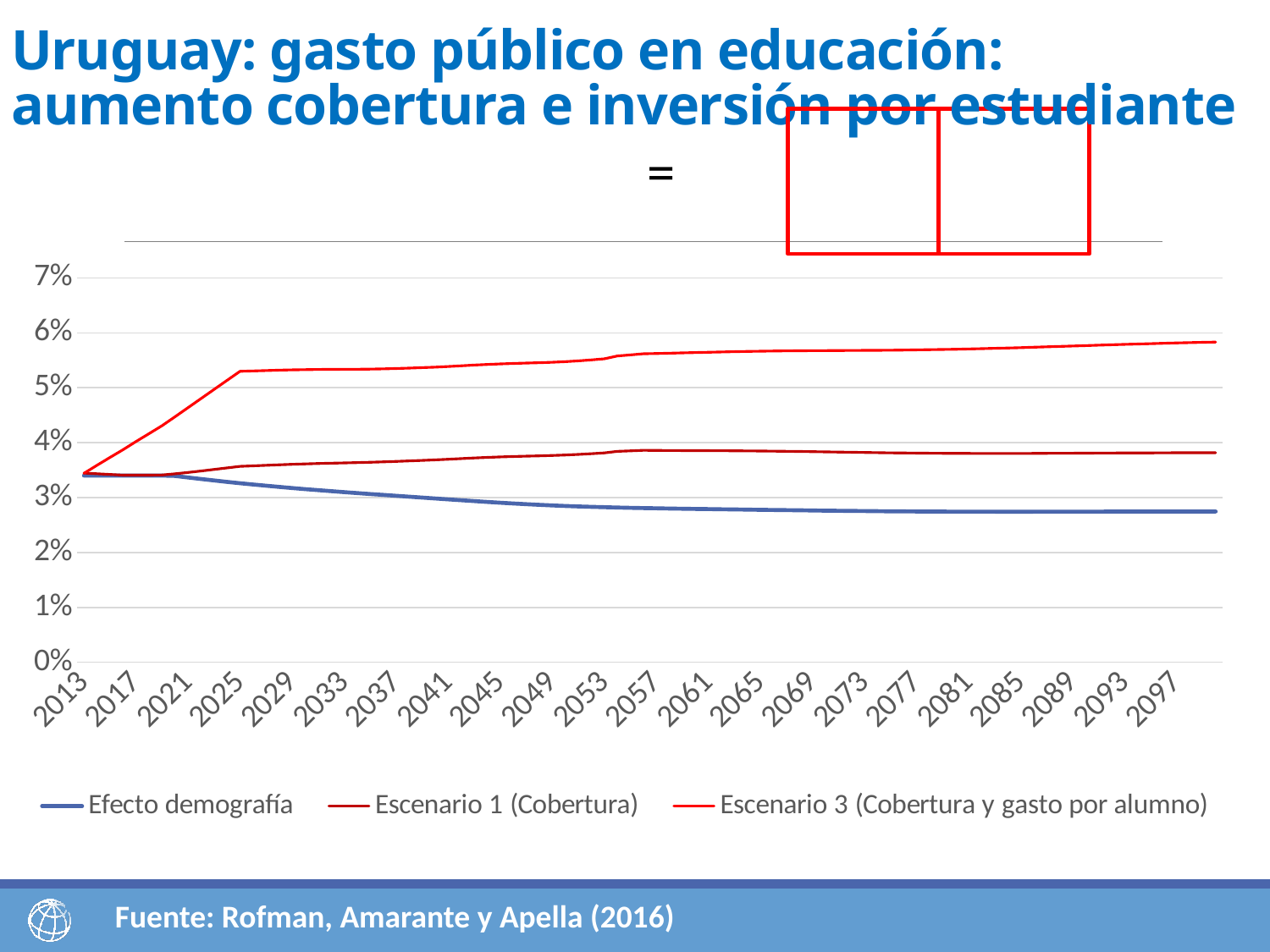
Which series has the highest value in 2097? Escenario 3 (Cobertura y gasto por alumno) Does the Escenario 3 (Cobertura y gasto por alumno) line rise or fall from 2013 to 2097? rise Is the value for Escenario 1 (Cobertura) in 2097 greater or less than 4%? less Is the value for Escenario 3 (Cobertura y gasto por alumno) in 2097 greater or less than 5%? greater Is the value for Efecto demografía in 2097 greater or less than 3%? less Which series has the lowest value in 2097? Efecto demografía How many year labels are shown on the x axis? 22 Which series is plotted in blue? Efecto demografía How many series does the legend list? 3 What kind of chart is shown on the slide? line chart What is the label of the third series in the legend? Escenario 3 (Cobertura y gasto por alumno) Does the Efecto demografía line rise or fall from 2013 to 2097? fall